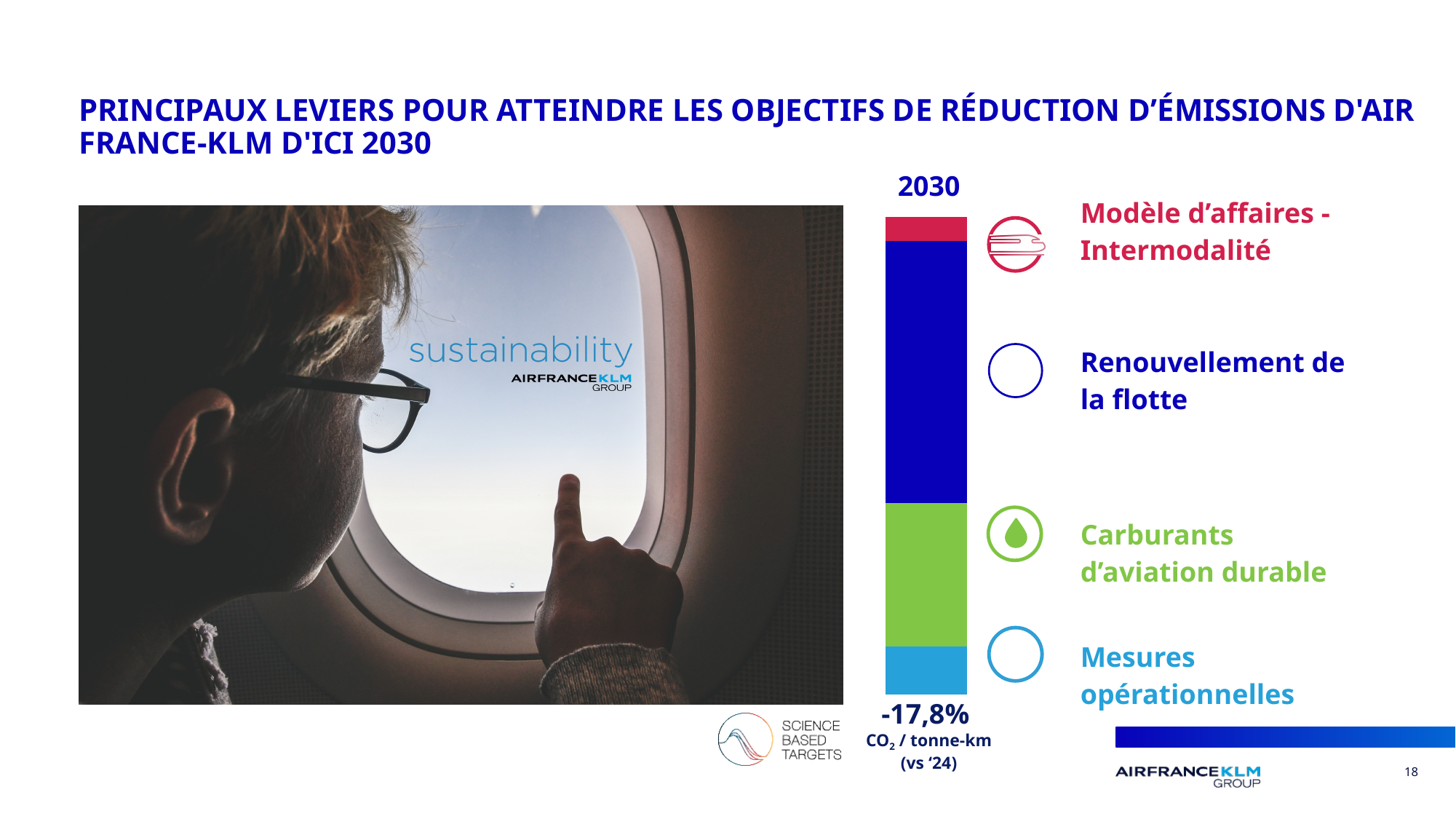
What kind of chart is shown on the slide? stacked bar chart What total reduction in CO2 per tonne-km is labelled on the 2030 bar? -17,8% Which segment is larger: Mesures opérationnelles or Modèle d'affaires - Intermodalité? Mesures opérationnelles Which lever accounts for the largest segment of the 2030 bar? Renouvellement de la flotte Which lever accounts for the smallest segment of the 2030 bar? Modèle d'affaires - Intermodalité What colour is the segment representing Carburants d'aviation durable? green How many segments make up the stacked bar for 2030? 4 Which segment is larger: Renouvellement de la flotte or Carburants d'aviation durable? Renouvellement de la flotte Which segment is larger: Carburants d'aviation durable or Mesures opérationnelles? Carburants d'aviation durable What year is labelled above the stacked bar? 2030